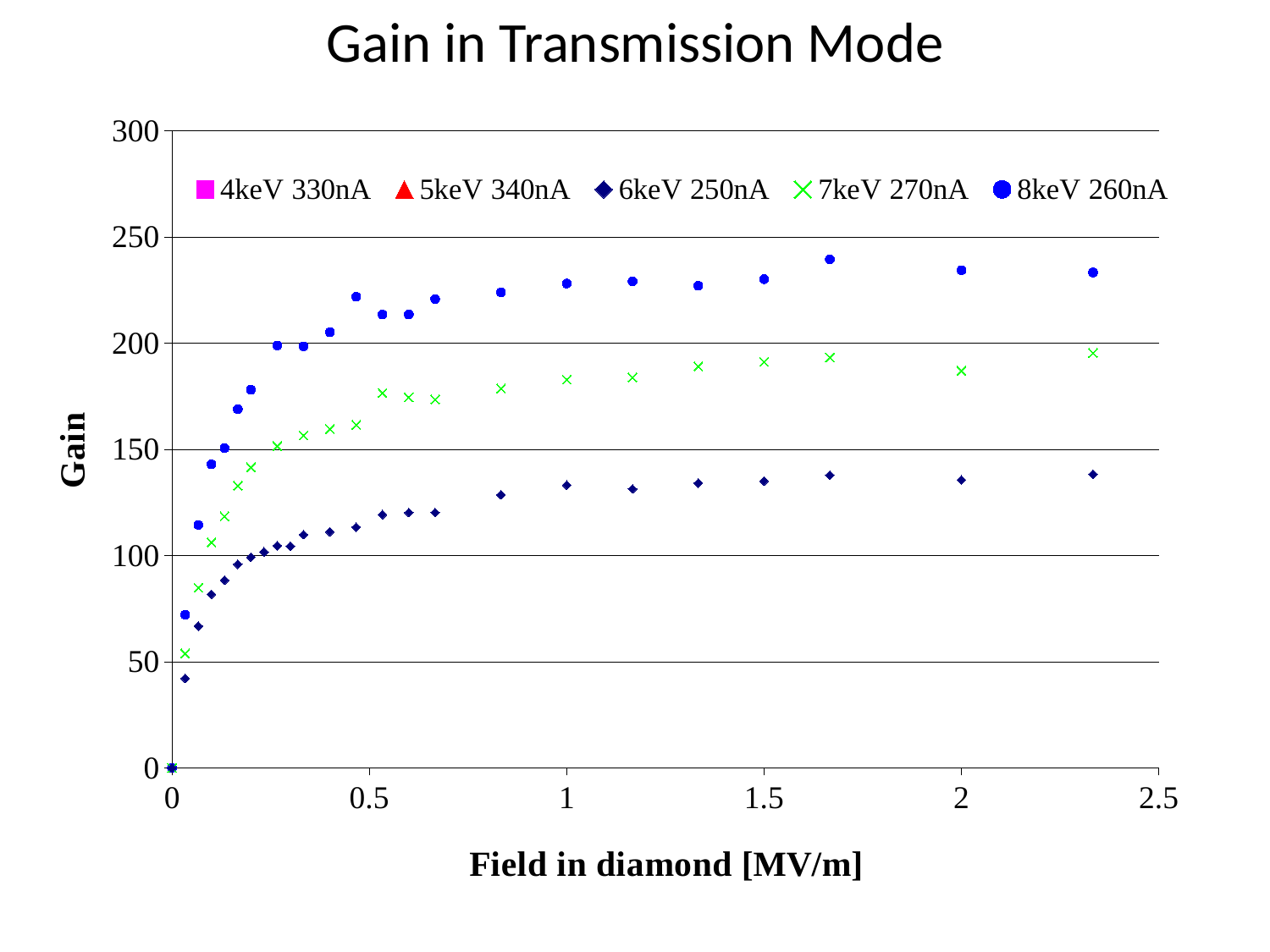
Which plotted series reaches the highest gain? 8keV 260nA What is the label of the x axis? Field in diamond [MV/m] Is the gain for the 7keV 270nA series at a field of 2 MV/m greater or less than 200? less What is the title of the chart? Gain in Transmission Mode How many series does the legend list? 5 Is the gain for the 8keV 260nA series at a field of 2 MV/m greater or less than 200? greater At a field of 1.5 MV/m, which series has the larger gain, 8keV 260nA or 6keV 250nA? 8keV 260nA Is the gain for the 6keV 250nA series at a field of 2 MV/m greater or less than 150? less What kind of chart is shown on the slide? scatter chart Does the gain for the 8keV 260nA series rise or fall as the field increases from 0 to 0.5 MV/m? rise